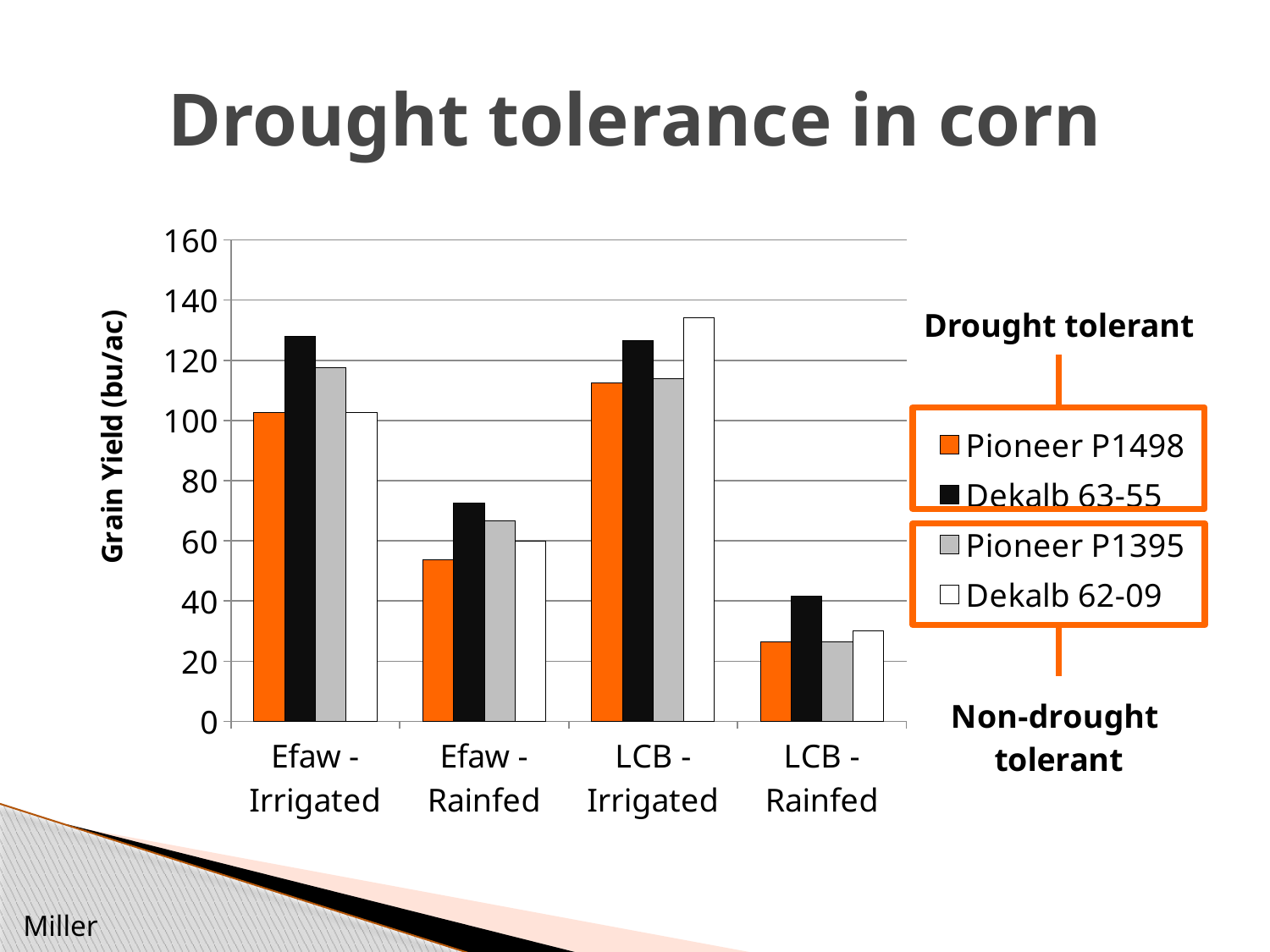
How many location/treatment categories are shown on the x axis? 4 Is the value for Pioneer P1498 at LCB - Rainfed greater or less than 40? less At LCB - Rainfed, which is larger: Dekalb 63-55 or Pioneer P1498? Dekalb 63-55 Is the value for Dekalb 62-09 at LCB - Irrigated greater or less than 120? greater What kind of chart is shown on the slide? Bar chart What is the label on the y axis? Grain Yield (bu/ac) Is the value for Pioneer P1498 at Efaw - Rainfed greater or less than 60? less Which hybrid has the highest grain yield at LCB - Irrigated? Dekalb 62-09 Which hybrid has the lowest grain yield at Efaw - Rainfed? Pioneer P1498 For Pioneer P1395, which is larger: the yield at Efaw - Irrigated or at Efaw - Rainfed? Efaw - Irrigated How many series does the legend list? 4